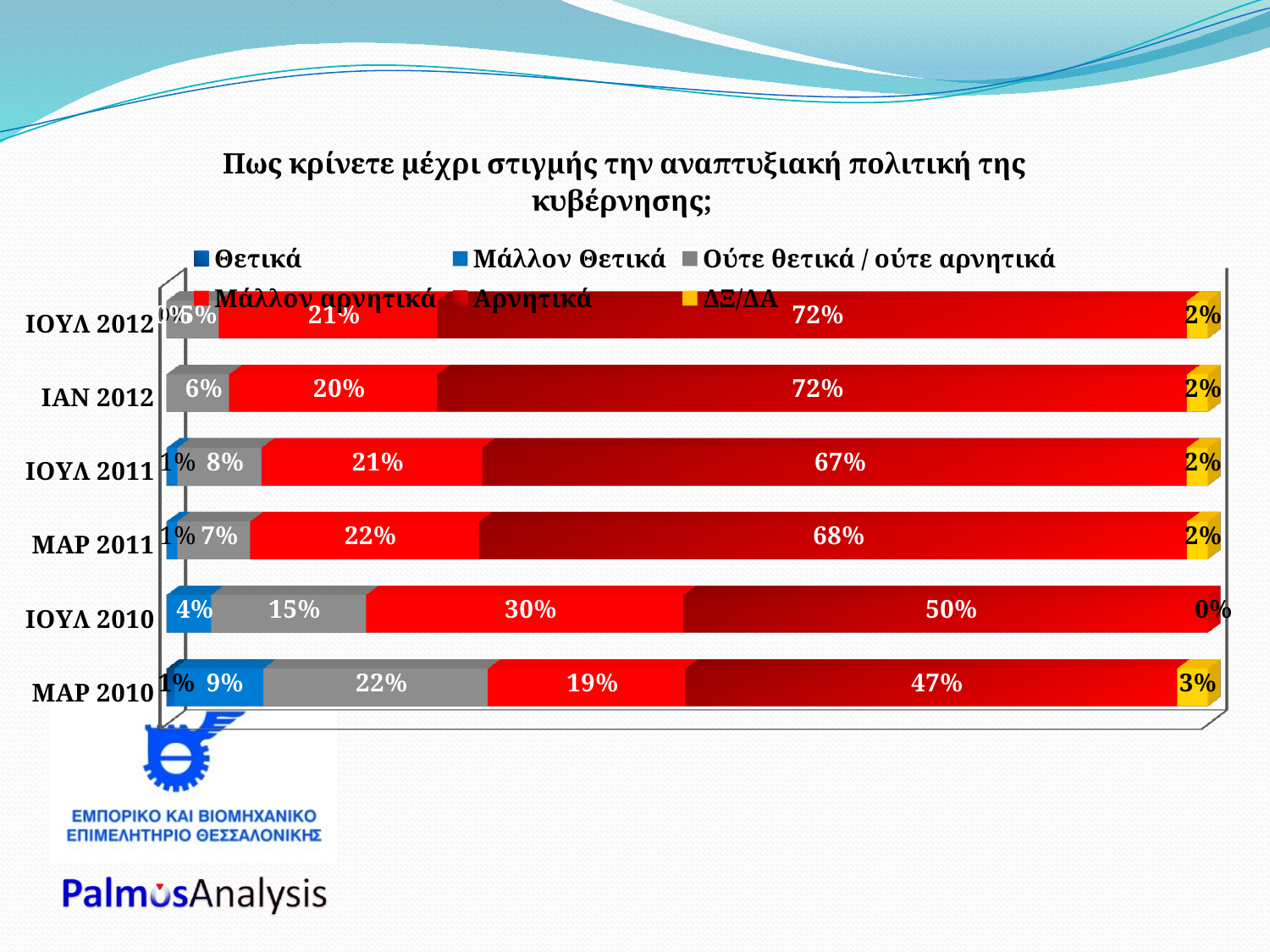
What kind of chart is shown on the slide? Stacked horizontal bar chart In which survey wave is the Ούτε θετικά / ούτε αρνητικά share highest? ΜΑΡ 2010 What is the value for Μάλλον αρνητικά in ΜΑΡ 2010? 19% How many series does the legend list? 6 How many survey waves (categories) are shown on the chart? 6 What is the value for ΔΞ/ΔΑ in ΙΟΥΛ 2010? 0% Which is larger: the Μάλλον αρνητικά value in ΙΟΥΛ 2010 or in ΜΑΡ 2011? ΙΟΥΛ 2010 What is the value for Μάλλον Θετικά in ΙΟΥΛ 2010? 4% Does the Αρνητικά share generally rise or fall from ΜΑΡ 2010 to ΙΟΥΛ 2012? Rise What is the value for Αρνητικά in ΙΟΥΛ 2010? 50% What is the difference between the Αρνητικά value in ΙΑΝ 2012 and in ΜΑΡ 2010? 25 percentage points In which survey wave is the Αρνητικά share lowest? ΜΑΡ 2010